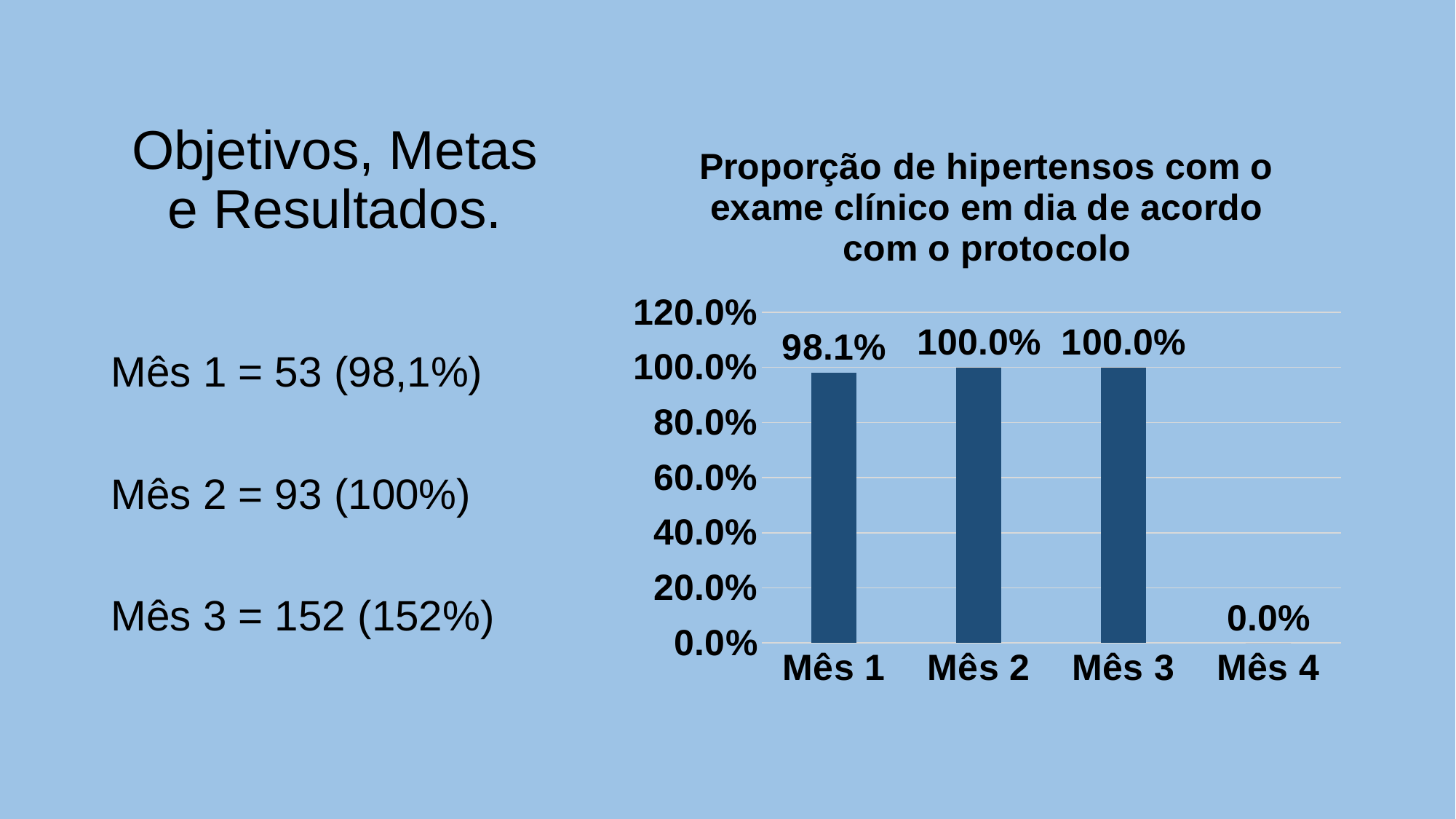
What kind of chart is shown? bar chart What is the value for Mês 4? 0.0% What is the value for Mês 2? 100.0% What is the difference between the values for Mês 2 and Mês 1? 1.9% Which category has the lowest value? Mês 4 What is the title of the chart? Proporção de hipertensos com o exame clínico em dia de acordo com o protocolo What is the highest value shown on the y axis? 120.0% Which is larger, the value for Mês 1 or the value for Mês 3? Mês 3 Do the values for Mês 2 and Mês 3 differ? No What is the value for Mês 1? 98.1% Is the value for Mês 1 greater or less than 80.0%? greater How many categories are shown on the x axis? 4